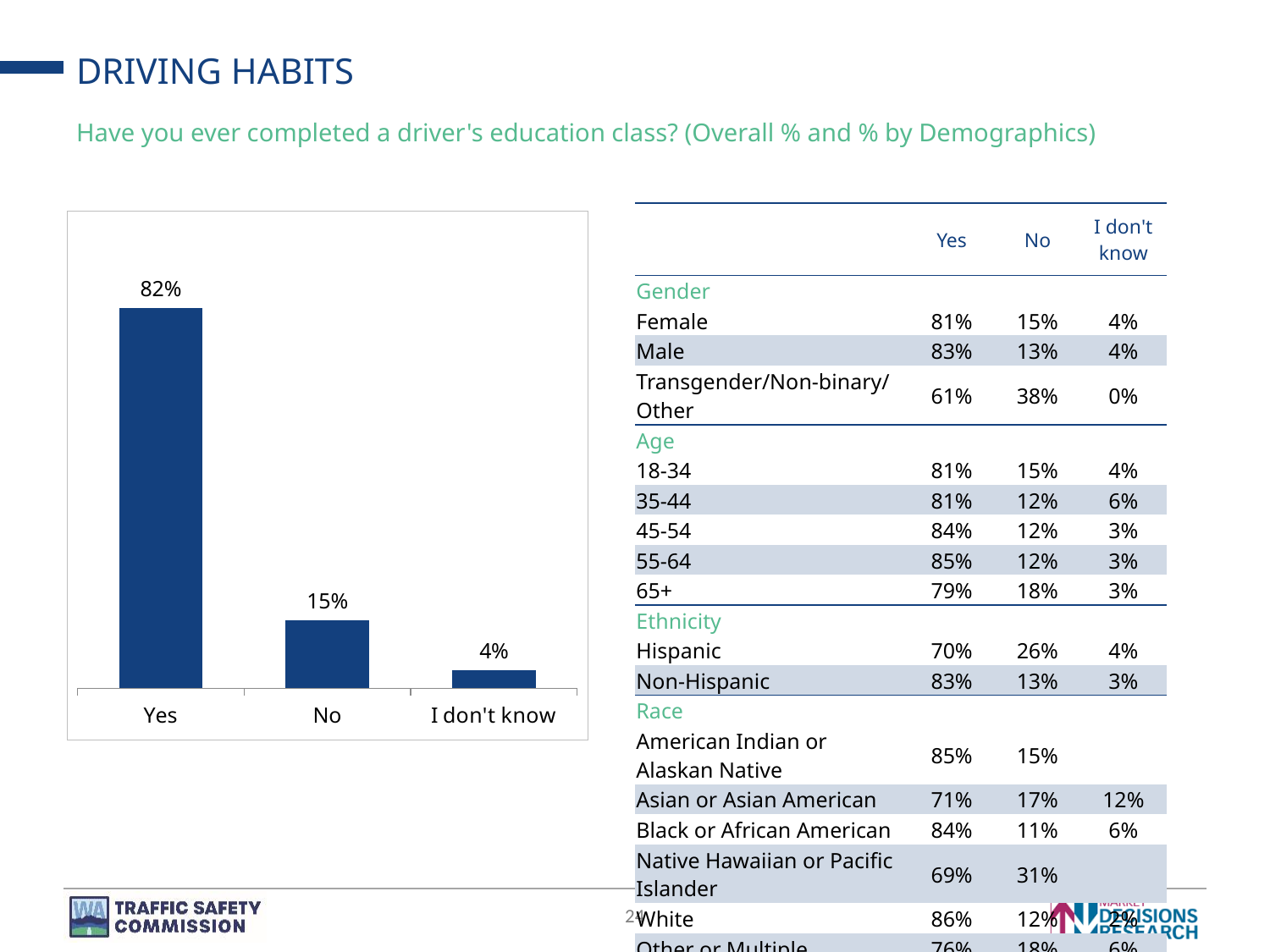
Do the values in the bar chart rise or fall from left to right? Fall What percentage of respondents answered "Yes" in the bar chart? 82% What survey question does the chart on the slide illustrate? Have you ever completed a driver's education class? What percentage of respondents answered "No" in the bar chart? 15% Which response category has the highest value in the bar chart? Yes Which is larger in the bar chart, the value for "No" or the value for "I don't know"? No Which response category has the lowest value in the bar chart? I don't know How many response categories are shown in the bar chart? 3 What is the difference between the "No" and "I don't know" values in the bar chart? 11% What percentage of respondents answered "I don't know" in the bar chart? 4% What is the difference between the "Yes" and "No" values in the bar chart? 67% What type of chart is shown on the slide? Bar chart